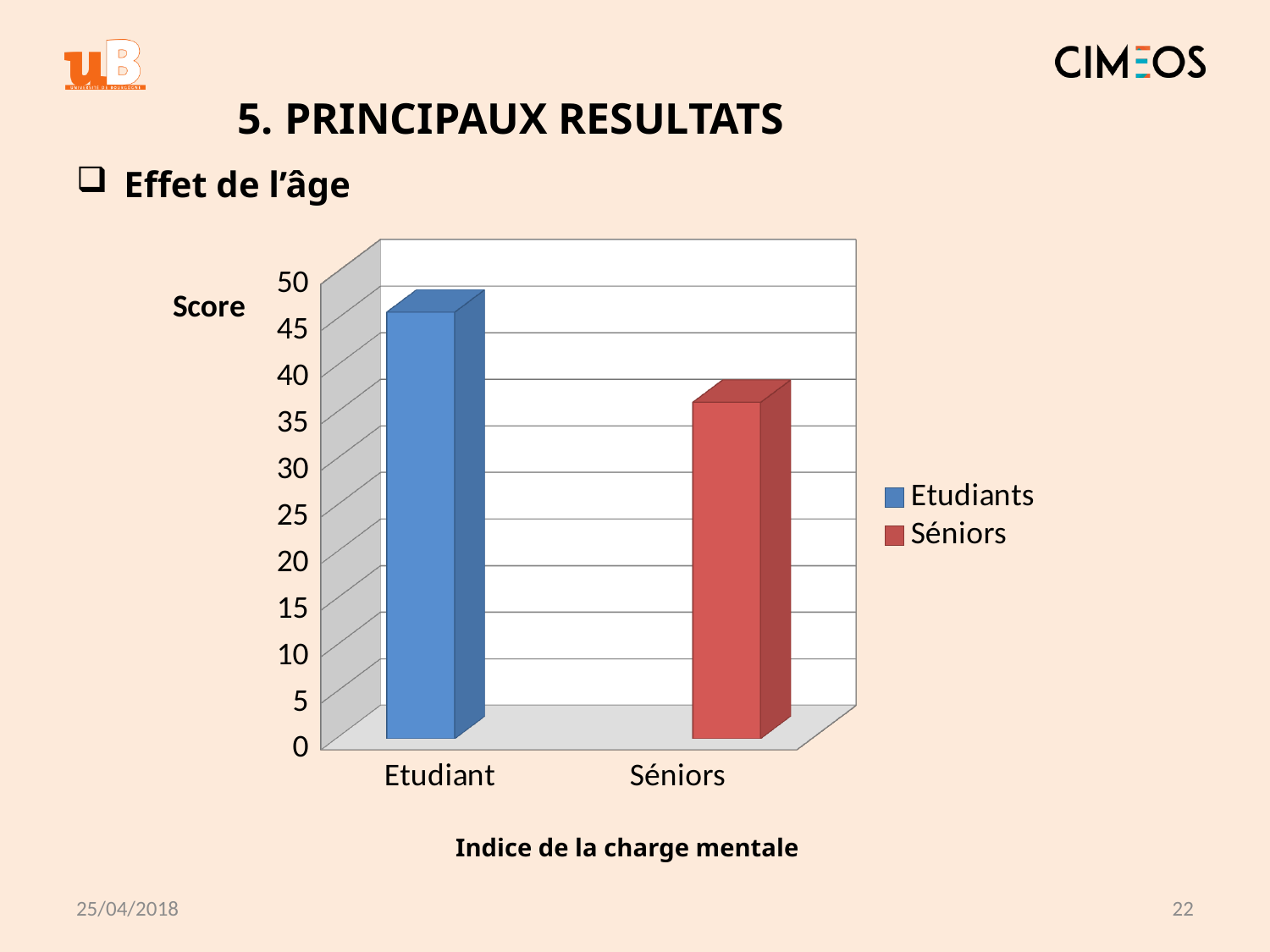
Which is larger, the score for Etudiant or the score for Séniors? Etudiant How many series does the chart legend list? 2 Is the score for Séniors greater or less than 30? greater Is the score for Etudiant greater or less than 40? greater How many categories are plotted on the x axis of the chart? 2 Is the score for Séniors greater or less than 40? less Which category has the lowest score in the chart? Séniors Which category has the highest score in the chart? Etudiant What is the title shown below the chart? Indice de la charge mentale What kind of chart is shown on the slide? bar chart What colour is the bar for Séniors in the chart? red